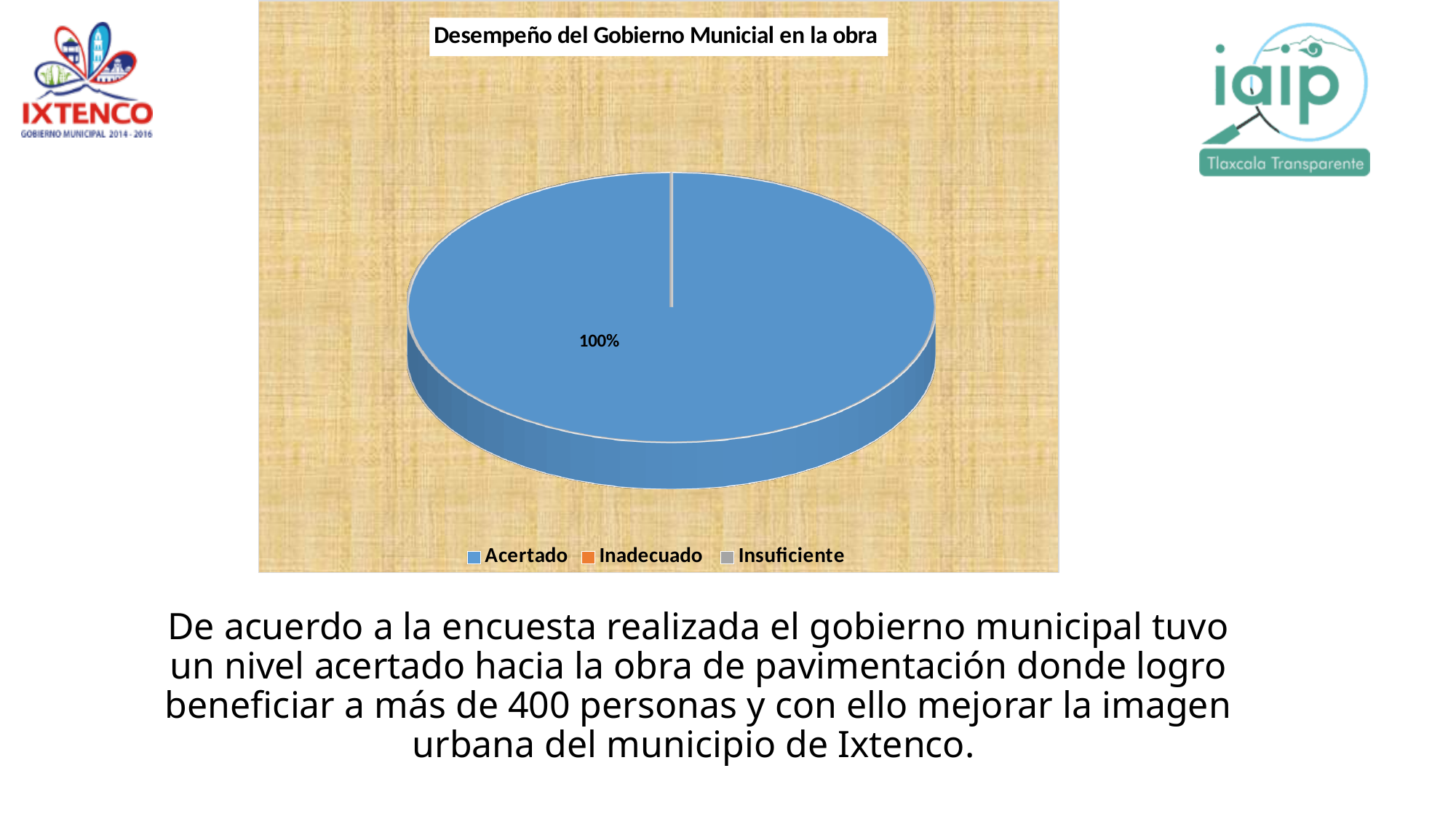
What share of the pie does the Acertado slice represent? 100% How many slices are visible in the pie? 1 Is the share for Acertado greater or less than 50%? greater How many entries does the chart legend list? 3 What is the title of the chart? Desempeño del Gobierno Municial en la obra Which legend entries are listed in the chart? Acertado, Inadecuado, Insuficiente What kind of chart is shown on the slide? Pie chart Which category accounts for the largest share of the pie? Acertado Which is larger, the share for Acertado or the share for Inadecuado? Acertado What percentage label is printed on the pie? 100%